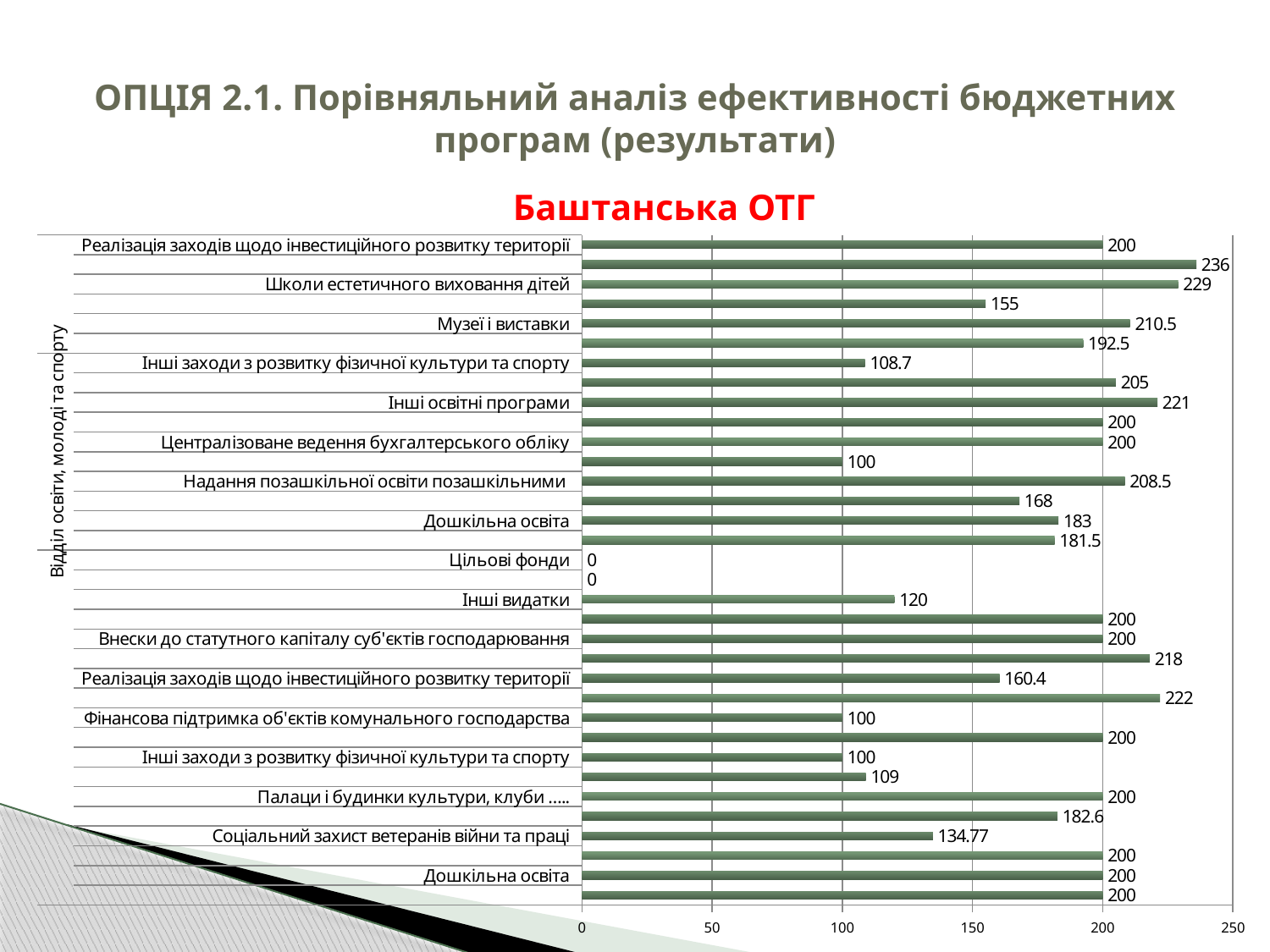
In the Баштанська ОТГ chart, what is the value for Соціальний захист ветеранів війни та праці? 134.77 In the Баштанська ОТГ chart, what is the value for Інші видатки? 120 In the Баштанська ОТГ chart, is the value for Інші видатки greater or less than 150? less In the Баштанська ОТГ chart, what is the difference between the values for Школи естетичного виховання дітей and Музеї і виставки? 18.5 In the Баштанська ОТГ chart, what is the value for Цільові фонди? 0 What kind of chart is shown on the slide? bar chart In the Баштанська ОТГ chart, what is the value for Інші освітні програми? 221 In the Баштанська ОТГ chart, which has the larger value: Інші освітні програми or Надання позашкільної освіти позашкільними? Інші освітні програми In the Баштанська ОТГ chart, what is the value for Надання позашкільної освіти позашкільними? 208.5 In the Баштанська ОТГ chart, what is the value for Школи естетичного виховання дітей? 229 In the Баштанська ОТГ chart, what is the value for Музеї і виставки? 210.5 What is the largest value labelled on the Баштанська ОТГ chart? 236